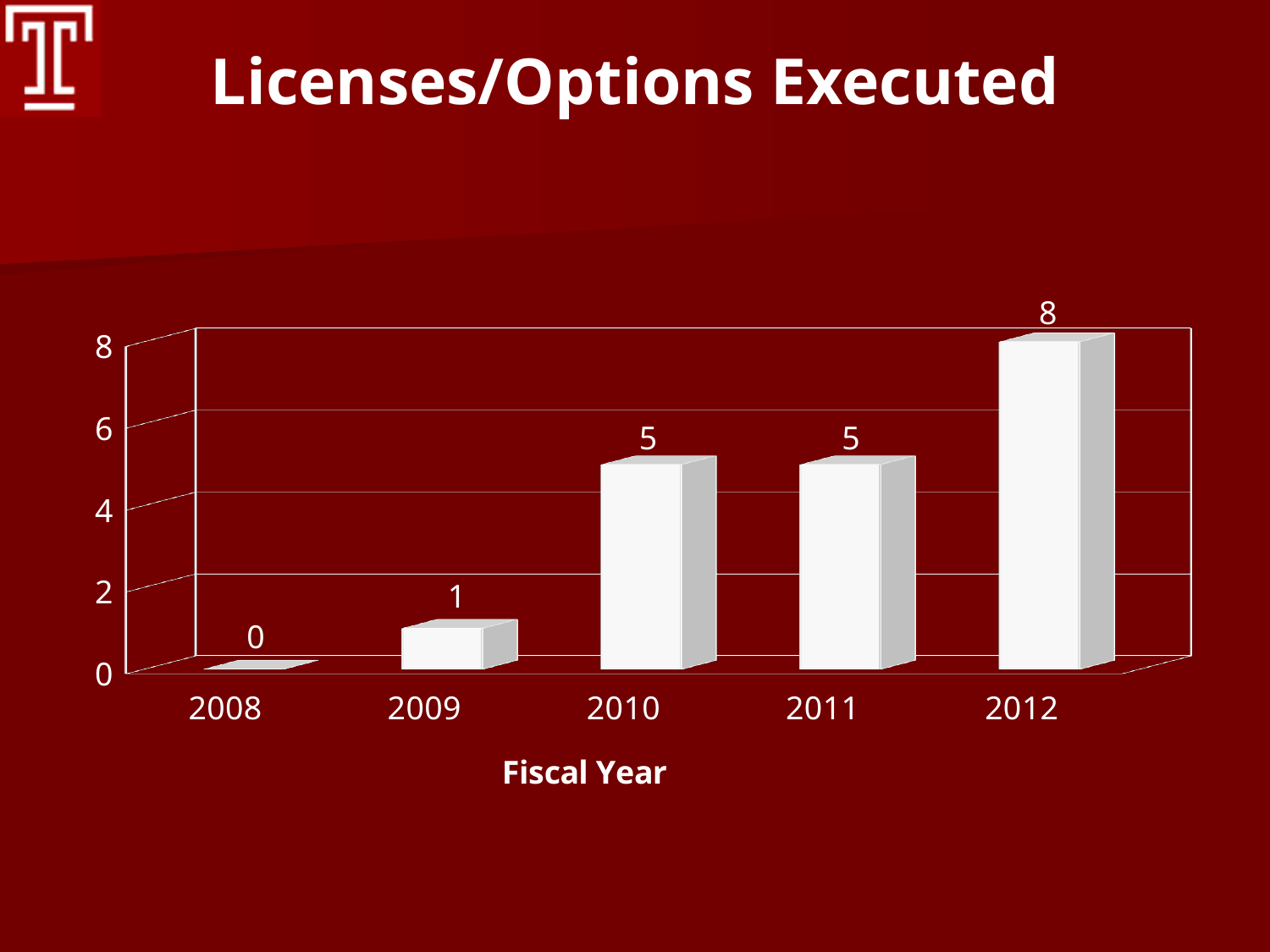
How many licenses/options were executed in fiscal year 2010? 5 Which fiscal year has the lowest number of licenses/options executed? 2008 What is the value shown for fiscal year 2008? 0 What is the title of the chart? Licenses/Options Executed Which fiscal year has a larger value, 2009 or 2012? 2012 Which fiscal year has the highest number of licenses/options executed? 2012 What is the difference between the values for 2010 and 2009? 4 What kind of chart is shown on the slide? Bar chart Do the values generally rise or fall from 2008 to 2012? Rise How many fiscal years are shown on the x axis? 5 What is the value shown for fiscal year 2009? 1 What is the difference between the values for 2012 and 2011? 3